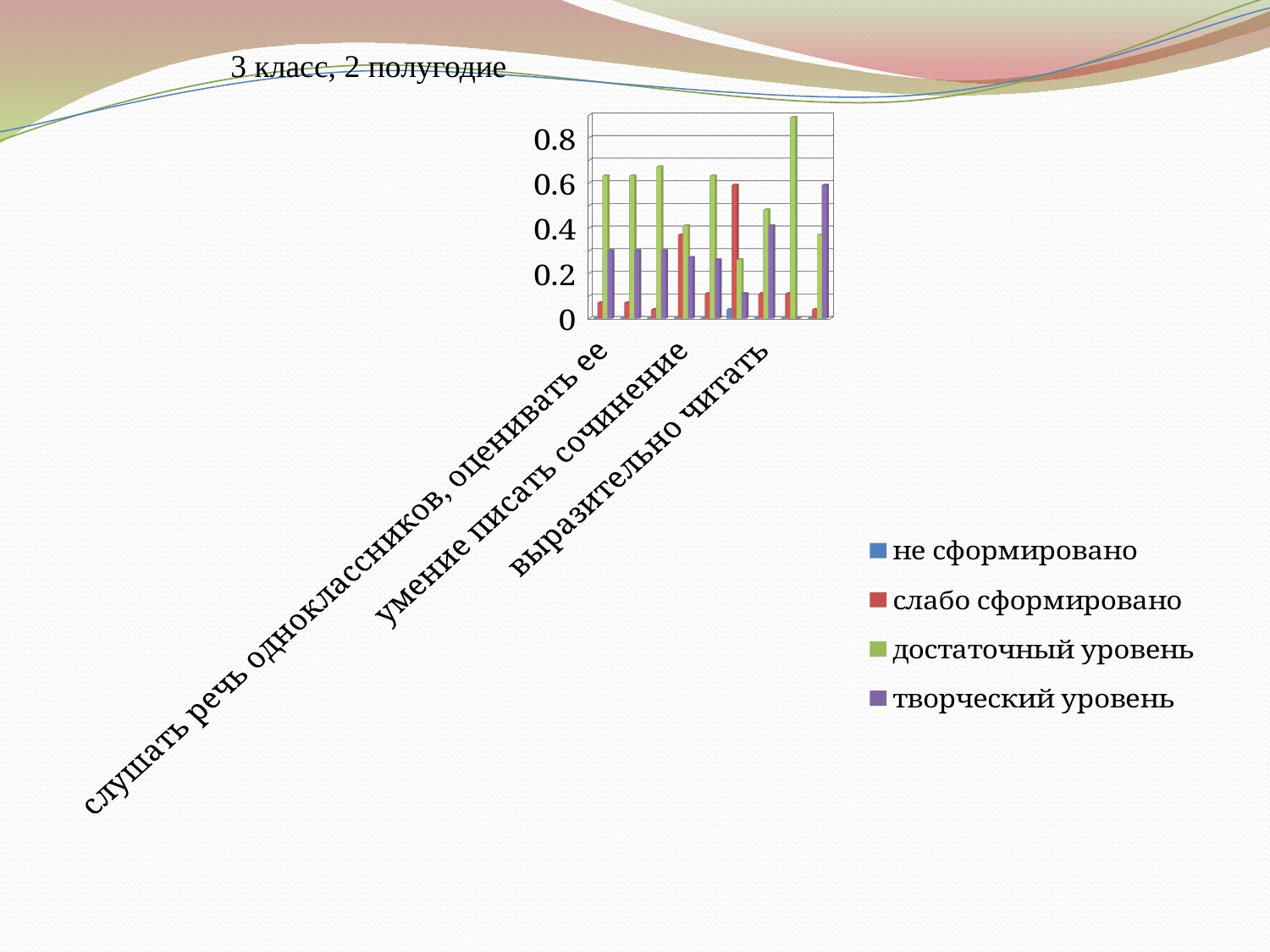
Which series has the smallest bars overall in the chart? не сформировано Is the tallest bar in the chart greater or less than 0.8? greater What is the highest value shown on the vertical axis? 0.8 What is the title of the chart? 3 класс, 2 полугодие How many groups of bars are plotted in the chart? 9 Is the tallest bar of the 'слабо сформировано' series greater or less than 0.8? less Which series has the tallest bar in the chart? достаточный уровень Which colour represents the series 'творческий уровень' in the legend? purple How many series does the legend list? 4 What kind of chart is shown on the slide? bar chart